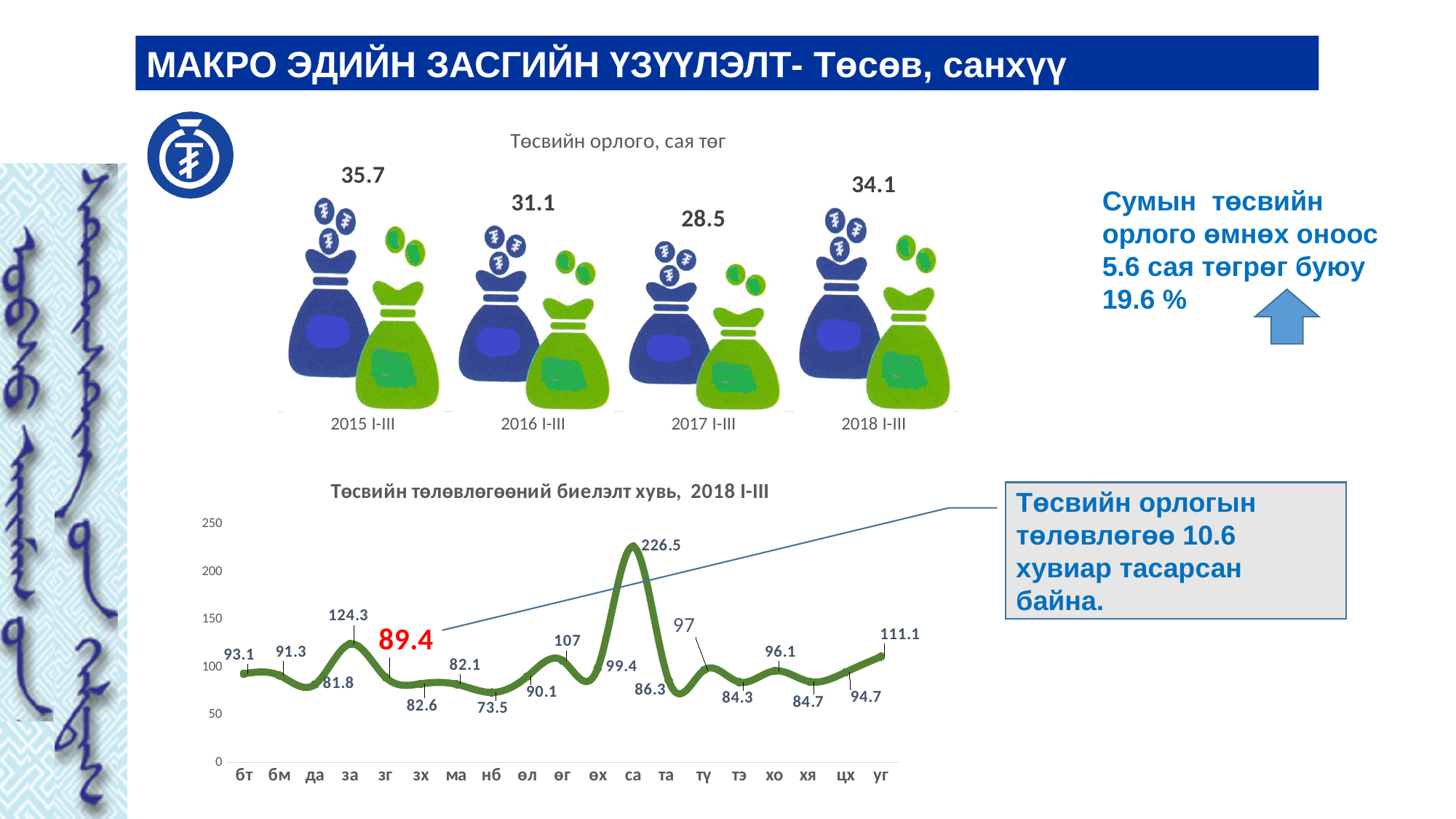
In the chart titled 'Төсвийн орлого, сая төг', what is the value for 2018 I-III? 34.1 In the chart titled 'Төсвийн орлого, сая төг', how many periods are shown? 4 In the chart titled 'Төсвийн орлого, сая төг', which period has the lowest value? 2017 I-III In the bottom chart 'Төсвийн төлөвлөгөөний биелэлт хувь, 2018 I-III', what is the value for зг? 89.4 In the bottom chart 'Төсвийн төлөвлөгөөний биелэлт хувь, 2018 I-III', how many categories are on the x axis? 19 In the bottom chart 'Төсвийн төлөвлөгөөний биелэлт хувь, 2018 I-III', what is the value for са? 226.5 In the bottom chart 'Төсвийн төлөвлөгөөний биелэлт хувь, 2018 I-III', which category has the highest value? са In the bottom chart 'Төсвийн төлөвлөгөөний биелэлт хувь, 2018 I-III', which category has the lowest value? нб In the chart titled 'Төсвийн орлого, сая төг', what is the difference between the 2018 I-III and 2017 I-III values? 5.6 What kind of chart is the bottom chart 'Төсвийн төлөвлөгөөний биелэлт хувь, 2018 I-III'? line chart In the bottom chart 'Төсвийн төлөвлөгөөний биелэлт хувь, 2018 I-III', which is larger, the value for за or the value for уг? за In the chart titled 'Төсвийн орлого, сая төг', what is the value for 2015 I-III? 35.7